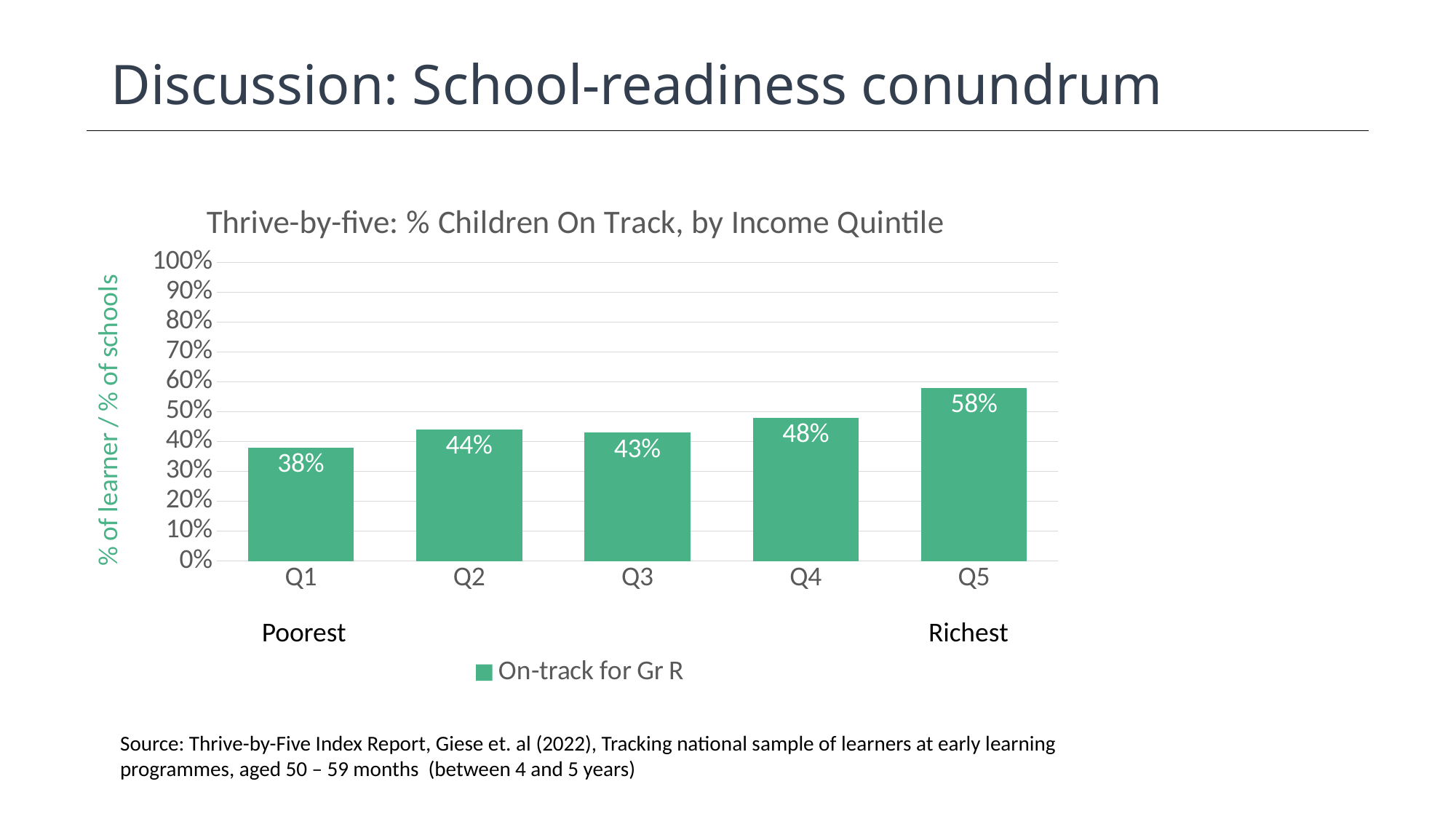
Is the value for Q5 greater or less than 50%? greater What is the title of the chart? Thrive-by-five: % Children On Track, by Income Quintile How many income quintiles are shown on the chart? 5 What is the difference between the values for Q4 and Q3? 5% What percentage of children are on track for Gr R in Q1? 38% Which income quintile has the lowest percentage of children on track? Q1 What is the value shown for Q3? 43% What kind of chart is shown on the slide? Bar chart What is the difference between the values for Q5 and Q1? 20% Which income quintile has the highest percentage of children on track? Q5 What is the value shown for Q4? 48% Which has a higher value, Q2 or Q3? Q2